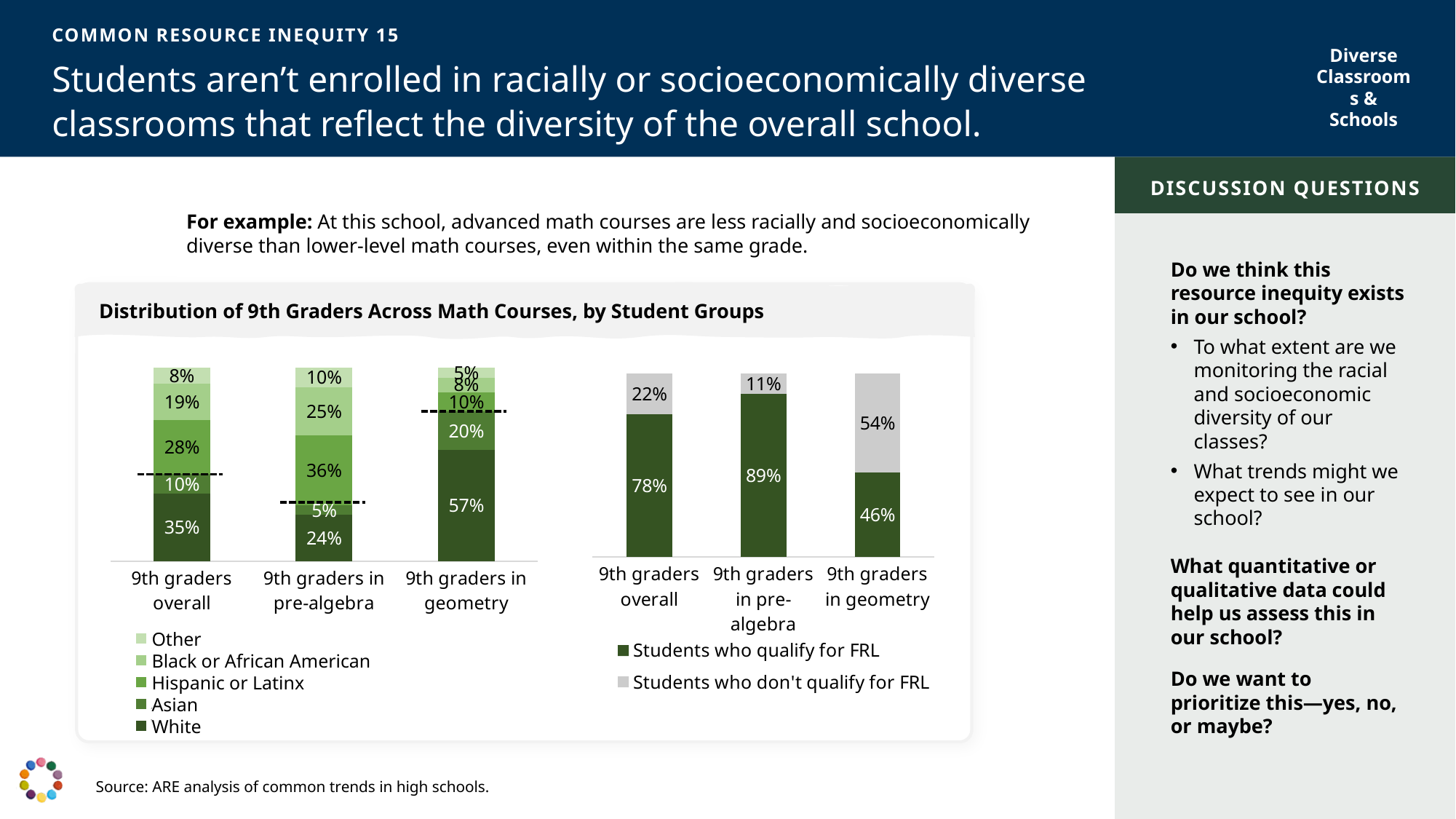
What is the title shown above the charts? Distribution of 9th Graders Across Math Courses, by Student Groups In the left chart, what share of 9th graders in geometry are White? 57% In the left chart, which course group has the lowest share of Asian students? 9th graders in pre-algebra In the right chart, what share of 9th graders overall don't qualify for FRL? 22% In the left chart, what share of 9th graders in pre-algebra are Hispanic or Latinx? 36% In the left chart, what is the difference between the White share in geometry and the White share in pre-algebra? 33 percentage points In the right chart, what share of 9th graders in geometry qualify for FRL? 46% In the right chart, which is larger: the FRL share for 9th graders overall or for 9th graders in geometry? 9th graders overall In the right chart, which course group has the highest share of students who qualify for FRL? 9th graders in pre-algebra What type of chart is the right chart? Stacked bar chart How many course groups are shown on the x axis of the left chart? 3 How many series does the legend of the left chart list? 5